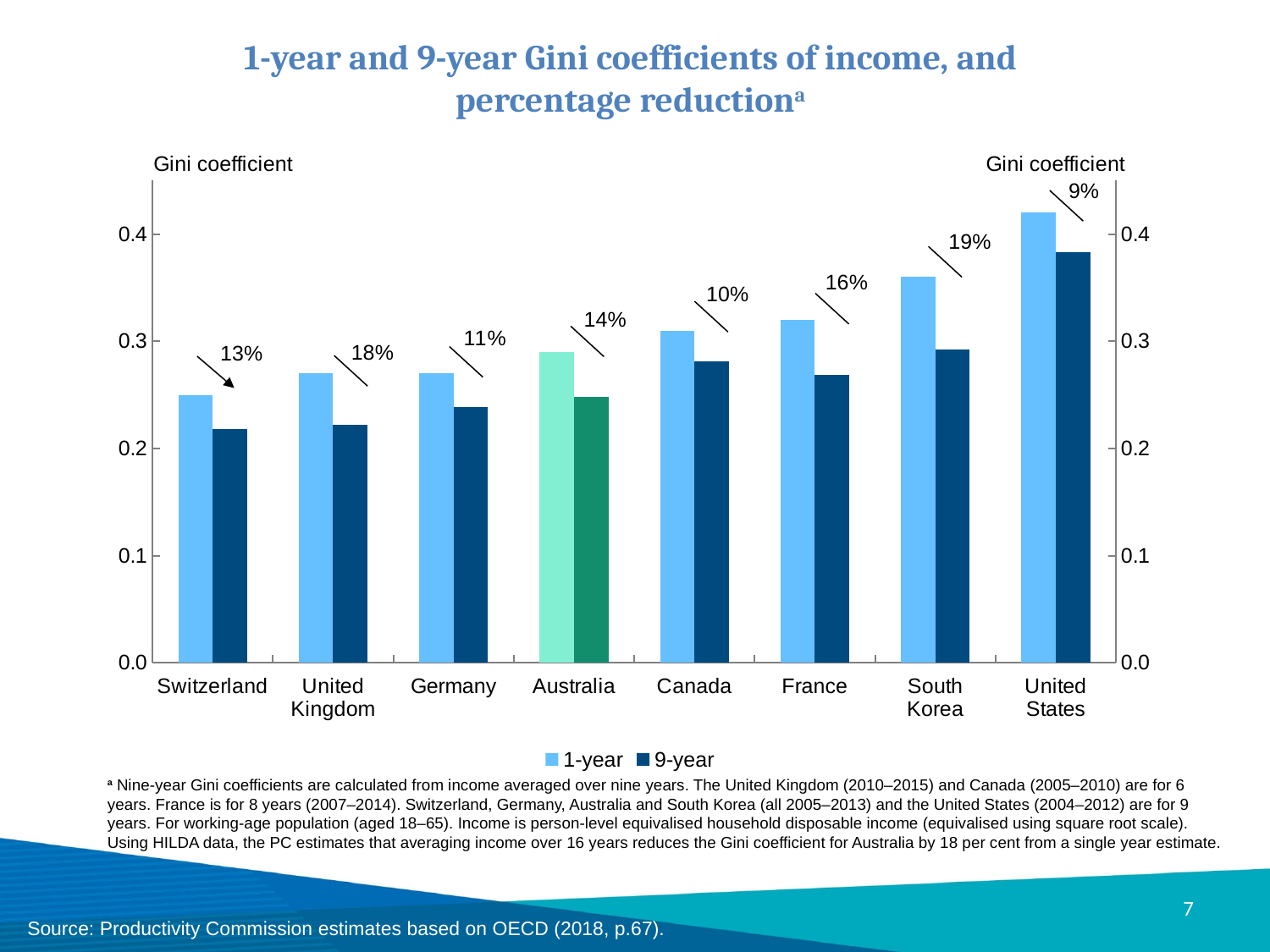
Is the 1-year Gini coefficient for the United States greater or less than 0.4? greater How many countries are shown on the x axis of the chart? 8 Which country has the highest 1-year Gini coefficient? United States Is the 9-year Gini coefficient for France greater or less than 0.3? less What kind of chart is shown on the slide? Bar chart Which has the larger labelled percentage reduction, the United Kingdom or Germany? United Kingdom How many series does the legend list? 2 What is the difference between the labelled percentage reductions for South Korea and the United States? 10 percentage points Which country has the lowest labelled percentage reduction? United States What percentage reduction is labelled for South Korea? 19% What percentage reduction is labelled for Australia? 14% Which country has the highest labelled percentage reduction? South Korea